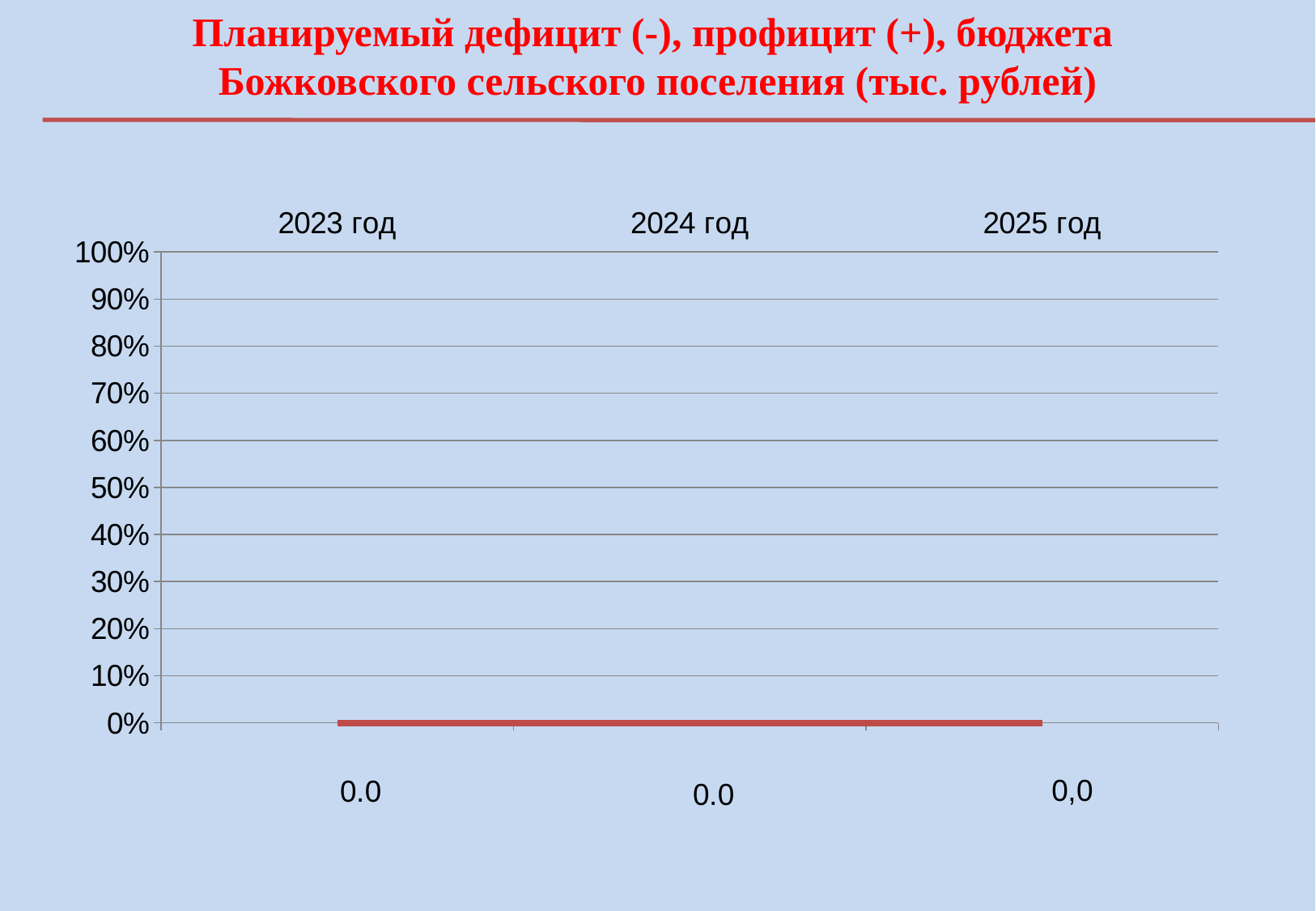
What is the value shown for 2023 год? 0.0 Do the values rise, fall, or stay flat from 2023 год to 2025 год? stay flat What is the title of the chart? Планируемый дефицит (-), профицит (+), бюджета Божковского сельского поселения (тыс. рублей) What is the difference between the values for 2023 год and 2024 год? 0.0 Is the value for 2024 год larger than, smaller than, or equal to the value for 2025 год? equal How many years (categories) are shown on the chart? 3 What is the highest tick shown on the vertical axis? 100% What is the value shown for 2025 год? 0,0 What is the value shown for 2024 год? 0.0 Is the value for 2023 год greater or less than 10%? less